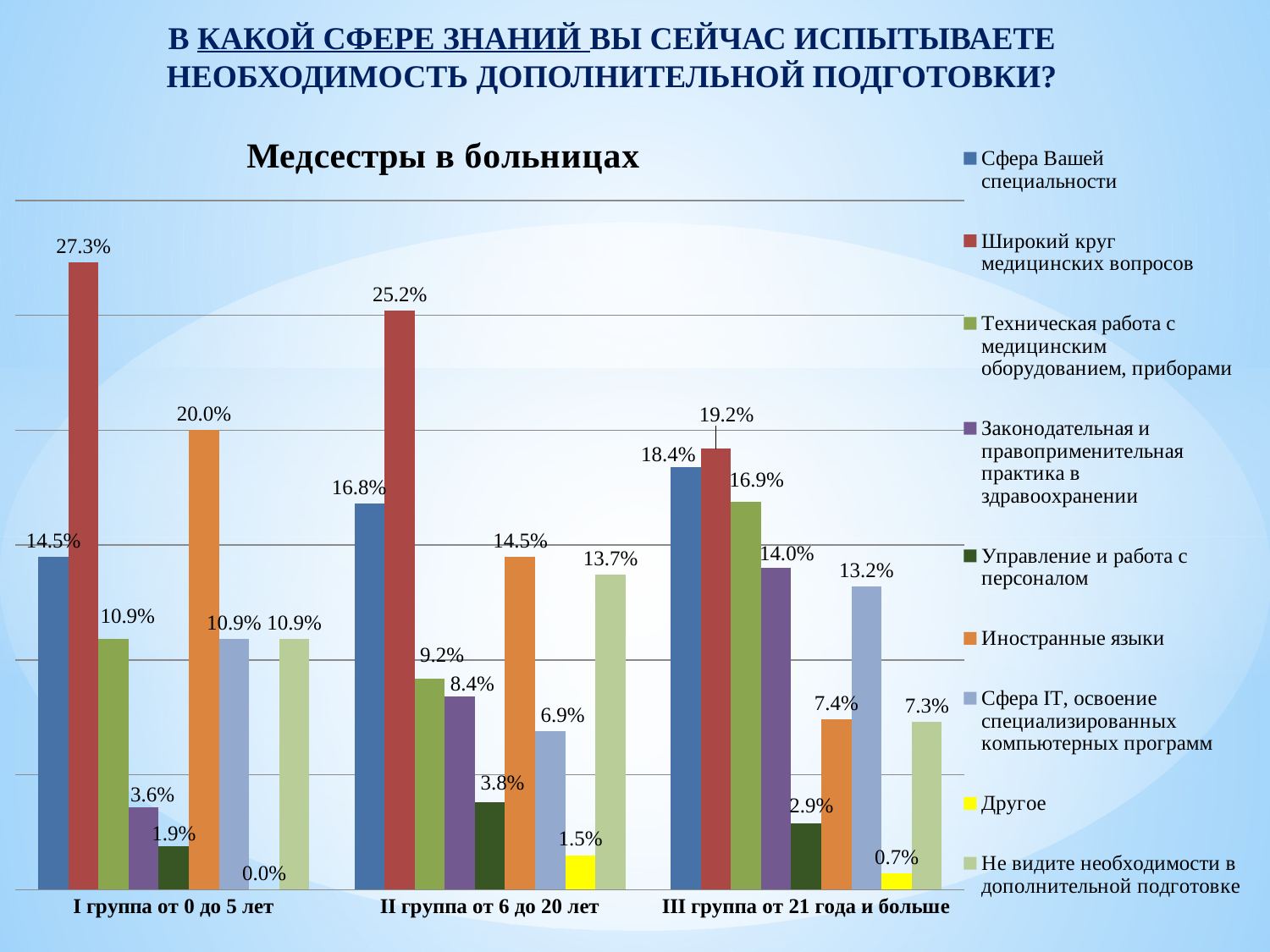
Which series has the lowest value in «I группа от 0 до 5 лет»? Другое How many groups (categories) are shown on the x axis? 3 What kind of chart is shown on the slide? Bar chart Which is larger in «III группа от 21 года и больше»: «Иностранные языки» or «Сфера IT, освоение специализированных компьютерных программ»? Сфера IT, освоение специализированных компьютерных программ Does the value for «Широкий круг медицинских вопросов» rise or fall from «I группа» to «III группа»? Fall What is the difference between «Широкий круг медицинских вопросов» and «Сфера Вашей специальности» in «II группа от 6 до 20 лет»? 8.4% What is the value for «Сфера IT, освоение специализированных компьютерных программ» in «III группа от 21 года и больше»? 13.2% What is the value for «Иностранные языки» in «II группа от 6 до 20 лет»? 14.5% How many series does the legend list? 9 What is the value for «Широкий круг медицинских вопросов» in «I группа от 0 до 5 лет»? 27.3% What is the title of the chart? Медсестры в больницах Which series has the highest value in «III группа от 21 года и больше»? Широкий круг медицинских вопросов